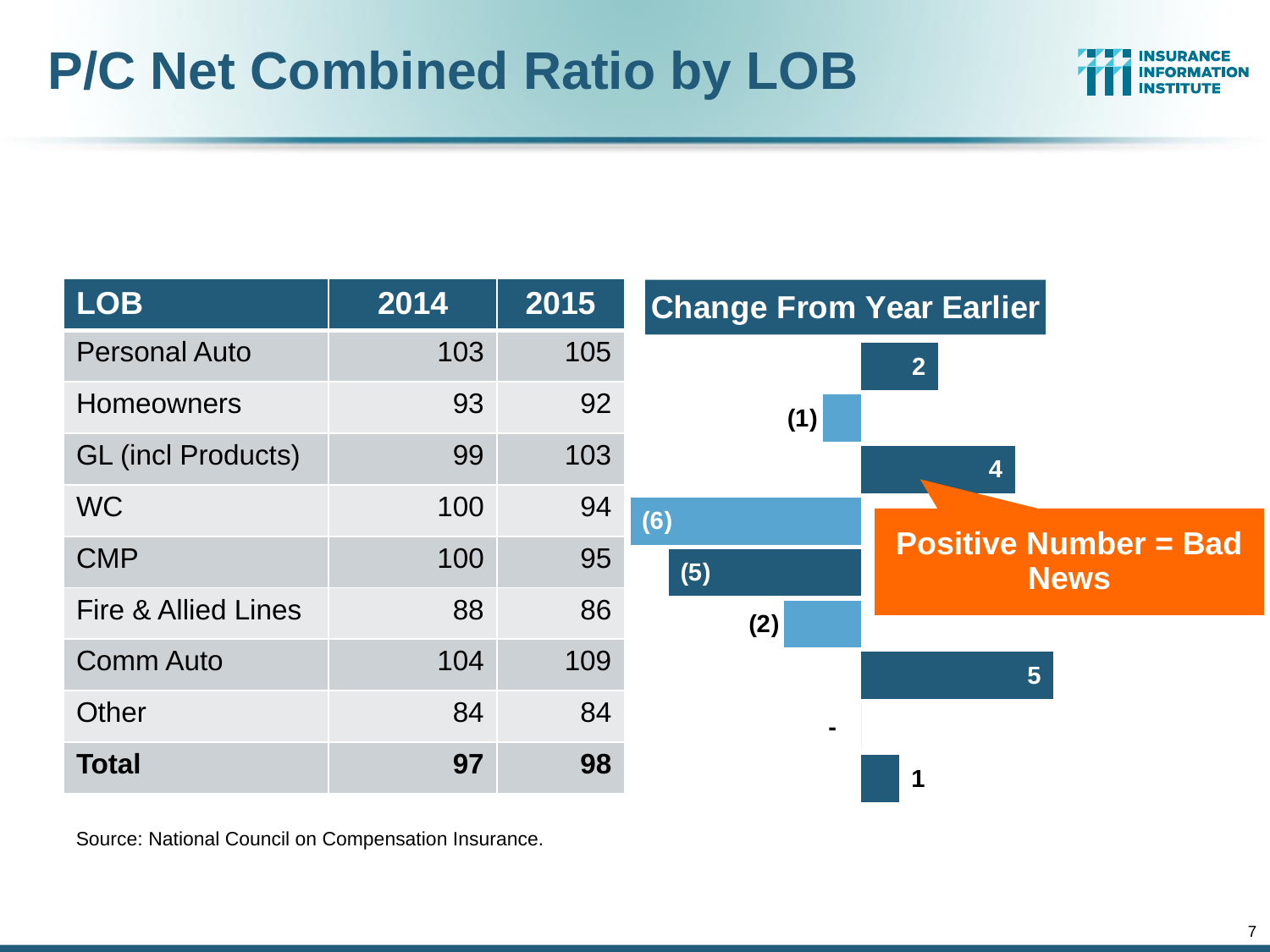
What kind of chart is shown under the heading 'Change From Year Earlier'? bar chart In the 'Change From Year Earlier' chart, is the bar for GL (incl Products) larger or smaller than the bar for Personal Auto? larger In the 'Change From Year Earlier' chart, what is the value shown on the bar aligned with the Personal Auto row? 2 In the 'Change From Year Earlier' chart, what is the difference between the change for Comm Auto and the change for Personal Auto? 3 What is the title of the chart on the right of the slide? Change From Year Earlier In the 'Change From Year Earlier' chart, what is the value shown on the bar aligned with the Total row? 1 In the 'Change From Year Earlier' chart, what is the value shown on the bar aligned with the WC row? (6) In the 'Change From Year Earlier' chart, which line of business has the largest negative change? WC In the 'Change From Year Earlier' chart, which line of business has the largest positive change? Comm Auto In the 'Change From Year Earlier' chart, what is the value shown on the bar aligned with the Comm Auto row? 5 How many lines of business (including Total) are plotted in the 'Change From Year Earlier' chart? 9